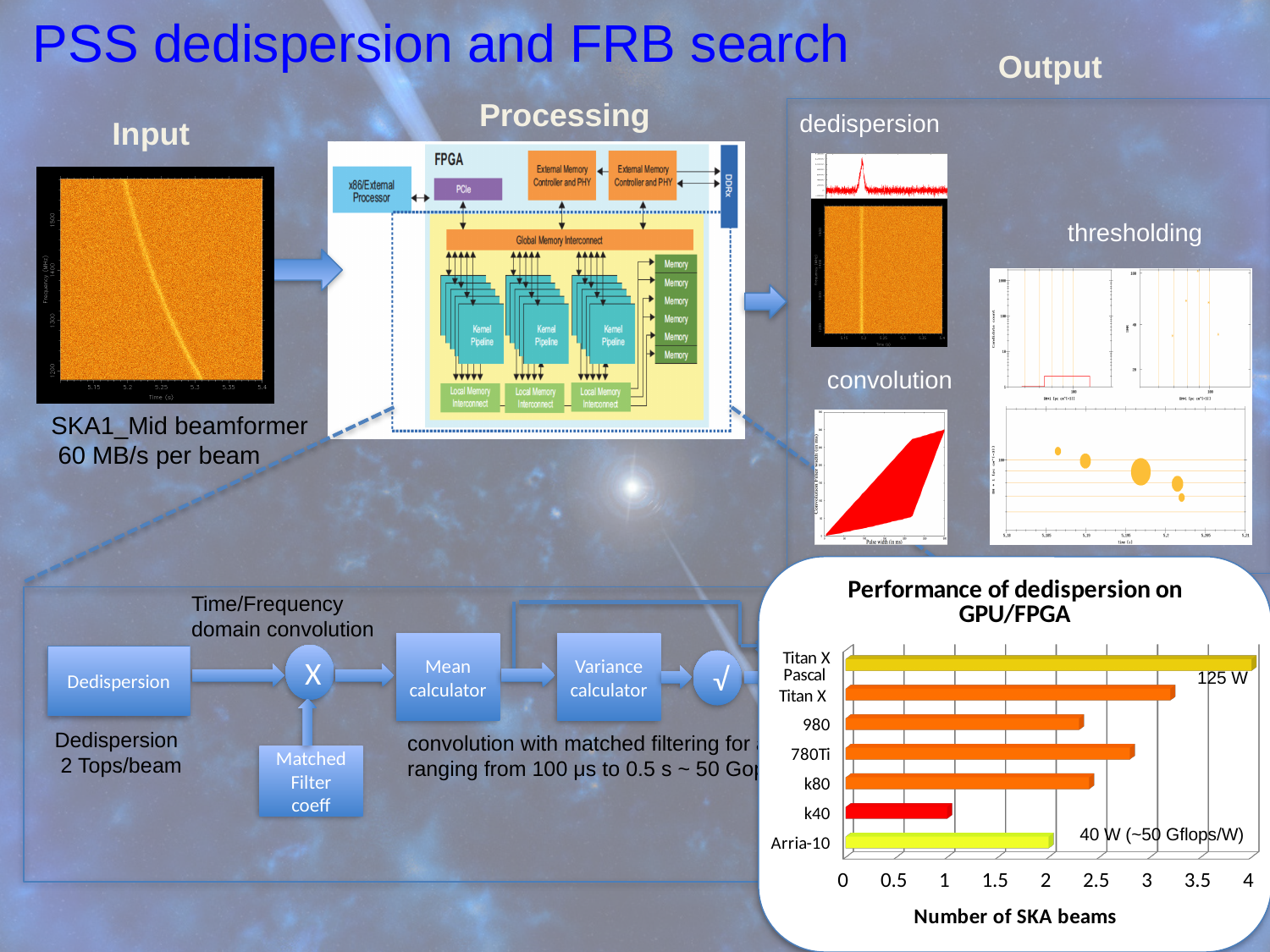
In the 'Performance of dedispersion on GPU/FPGA' chart, is the value for k40 greater or less than 1.5? less What is the x-axis title of the 'Performance of dedispersion on GPU/FPGA' chart? Number of SKA beams How many devices are listed on the y axis of the 'Performance of dedispersion on GPU/FPGA' chart? 7 What type of chart is 'Performance of dedispersion on GPU/FPGA'? bar chart In the 'Performance of dedispersion on GPU/FPGA' chart, is the value for Arria-10 greater or less than 1.5? greater In the 'Performance of dedispersion on GPU/FPGA' chart, is the value for Titan X greater or less than 3? greater In the 'Performance of dedispersion on GPU/FPGA' chart, what power annotation is shown next to the Arria-10 bar? 40 W (~50 Gflops/W) In the 'Performance of dedispersion on GPU/FPGA' chart, which has more SKA beams, 780Ti or 980? 780Ti In the 'Performance of dedispersion on GPU/FPGA' chart, which device has the highest number of SKA beams? Titan X Pascal In the 'Performance of dedispersion on GPU/FPGA' chart, which device has the lowest number of SKA beams? k40